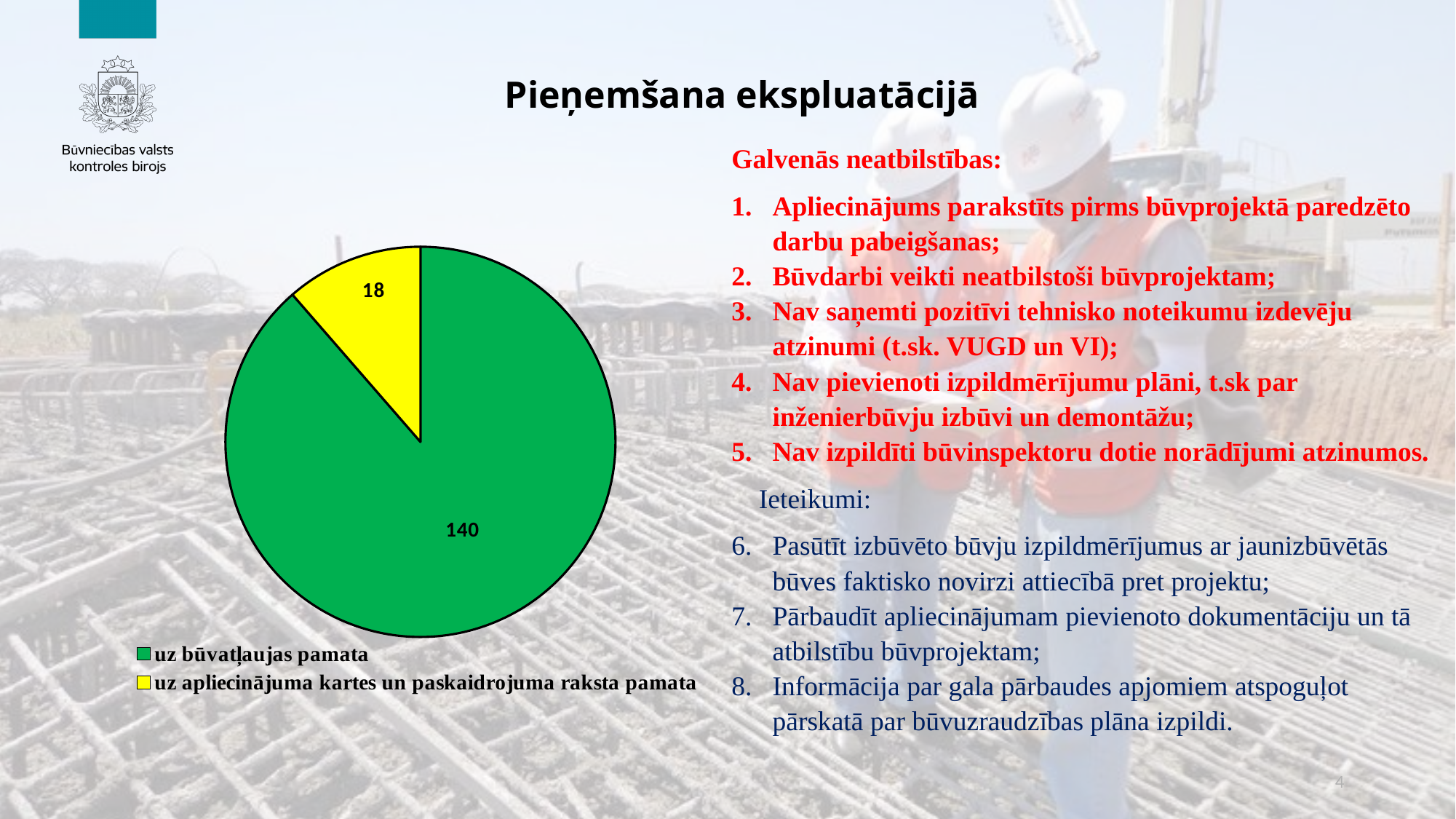
What is the total of all slices in the pie chart? 158 Which category has the largest slice of the pie? uz būvatļaujas pamata What is the difference between the value for "uz būvatļaujas pamata" and the value for "uz apliecinājuma kartes un paskaidrojuma raksta pamata"? 122 How many slices does the pie chart have? 2 What is the value for "uz apliecinājuma kartes un paskaidrojuma raksta pamata"? 18 What type of chart is shown on the slide? pie chart How many entries does the legend list? 2 What share of the pie does "uz apliecinājuma kartes un paskaidrojuma raksta pamata" represent, to the nearest whole percent? 11% Which is larger: the value for "uz būvatļaujas pamata" or the value for "uz apliecinājuma kartes un paskaidrojuma raksta pamata"? uz būvatļaujas pamata Which category has the smallest slice of the pie? uz apliecinājuma kartes un paskaidrojuma raksta pamata What colour is the slice for "uz būvatļaujas pamata"? green What is the value for "uz būvatļaujas pamata"? 140